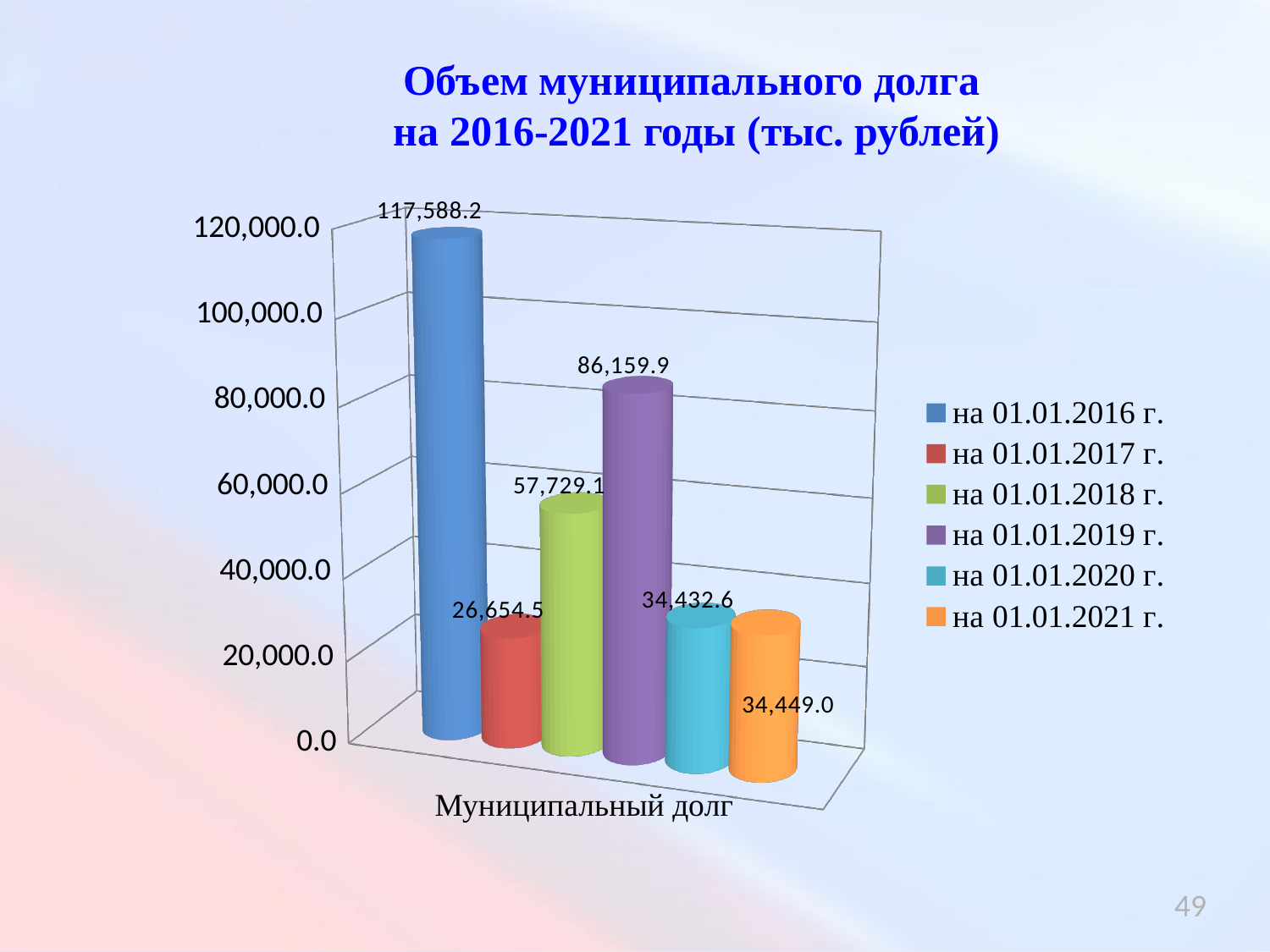
Which series has the highest value? на 01.01.2016 г. What is the value for на 01.01.2021 г.? 34,449.0 What is the value for на 01.01.2019 г.? 86,159.9 What is the value for на 01.01.2016 г.? 117,588.2 How many series does the legend list? 6 What kind of chart is shown on the slide? bar chart What is the difference between the values for на 01.01.2016 г. and на 01.01.2017 г.? 90,933.7 What is the title of the chart? Объем муниципального долга на 2016-2021 годы (тыс. рублей) Which series has the lowest value? на 01.01.2017 г. What is the difference between the values for на 01.01.2019 г. and на 01.01.2018 г.? 28,430.8 Which is larger, the value for на 01.01.2018 г. or на 01.01.2019 г.? на 01.01.2019 г. Is the value for на 01.01.2017 г. greater or less than 40,000.0? less